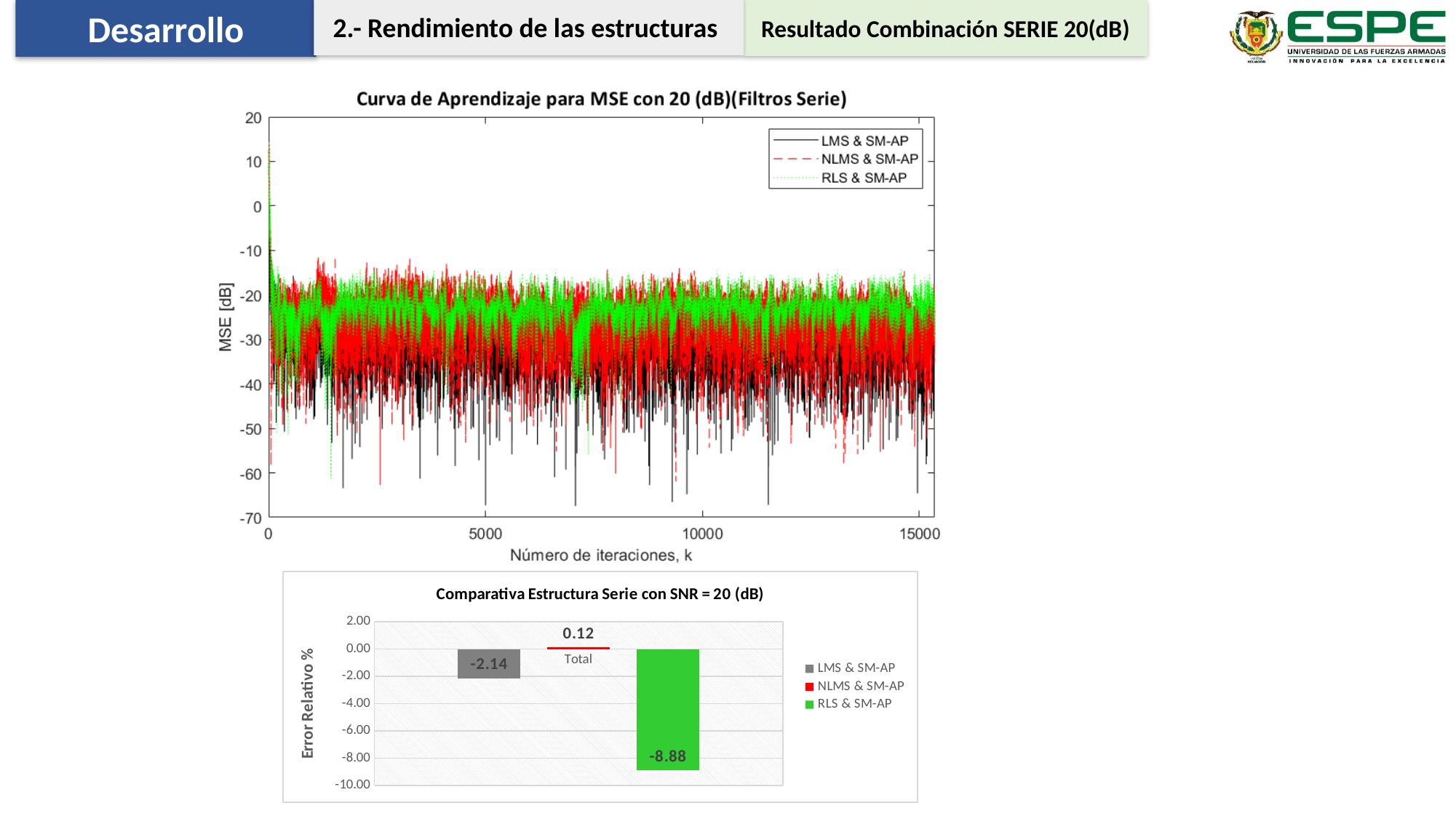
In the upper chart titled "Curva de Aprendizaje para MSE con 20 (dB)(Filtros Serie)", how many series does the legend list? 3 In the bar chart titled "Comparativa Estructura Serie con SNR = 20 (dB)", what is the difference between the values for LMS & SM-AP and RLS & SM-AP? 6.74 In the bar chart titled "Comparativa Estructura Serie con SNR = 20 (dB)", what is the value for RLS & SM-AP? -8.88 In the upper chart titled "Curva de Aprendizaje para MSE con 20 (dB)(Filtros Serie)", what is the x-axis label? Número de iteraciones, k In the bar chart titled "Comparativa Estructura Serie con SNR = 20 (dB)", what is the value for LMS & SM-AP? -2.14 What kind of chart is the lower chart titled "Comparativa Estructura Serie con SNR = 20 (dB)"? Bar chart In the bar chart titled "Comparativa Estructura Serie con SNR = 20 (dB)", what is the value for NLMS & SM-AP? 0.12 In the bar chart titled "Comparativa Estructura Serie con SNR = 20 (dB)", which is larger, the value for LMS & SM-AP or the value for NLMS & SM-AP? NLMS & SM-AP In the bar chart titled "Comparativa Estructura Serie con SNR = 20 (dB)", how many series does the legend list? 3 In the bar chart titled "Comparativa Estructura Serie con SNR = 20 (dB)", which series has the highest value? NLMS & SM-AP In the bar chart titled "Comparativa Estructura Serie con SNR = 20 (dB)", which series has the lowest value? RLS & SM-AP In the bar chart titled "Comparativa Estructura Serie con SNR = 20 (dB)", what is the y-axis label? Error Relativo %